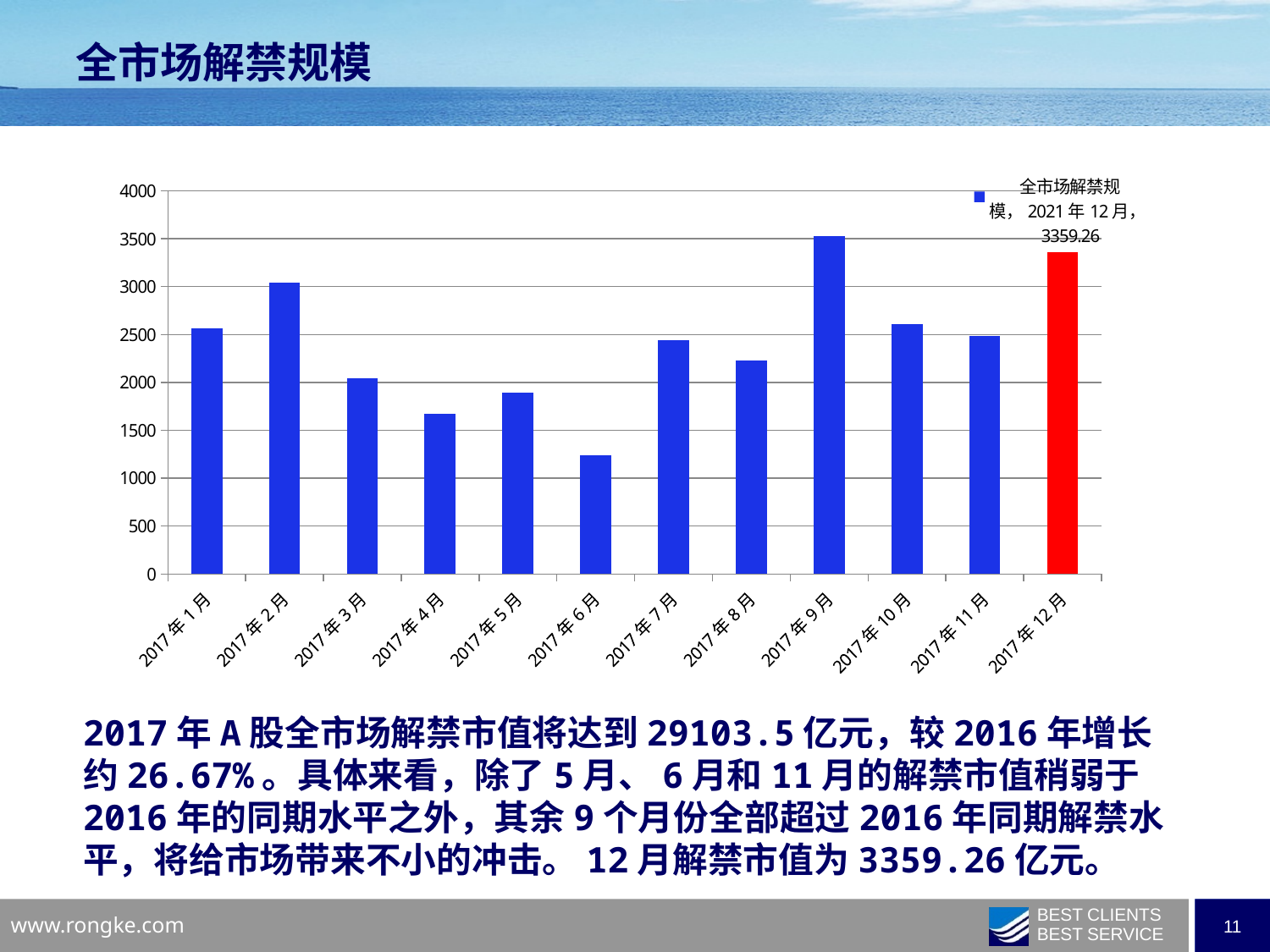
Which month has the highest value? 2017年9月 Which month's bar is coloured red? 2017年12月 What kind of chart is shown on the slide? bar chart Which is larger, the value for 2017年1月 or 2017年2月? 2017年2月 How many months are shown on the x axis? 12 Is the value for 2017年6月 greater or less than 1500? less Which is larger, the value for 2017年7月 or 2017年8月? 2017年7月 From 2017年9月 to 2017年11月, do the values rise or fall? fall Which month has the lowest value? 2017年6月 What is the value for 2017年12月? 3359.26 Is the value for 2017年4月 greater or less than 2000? less